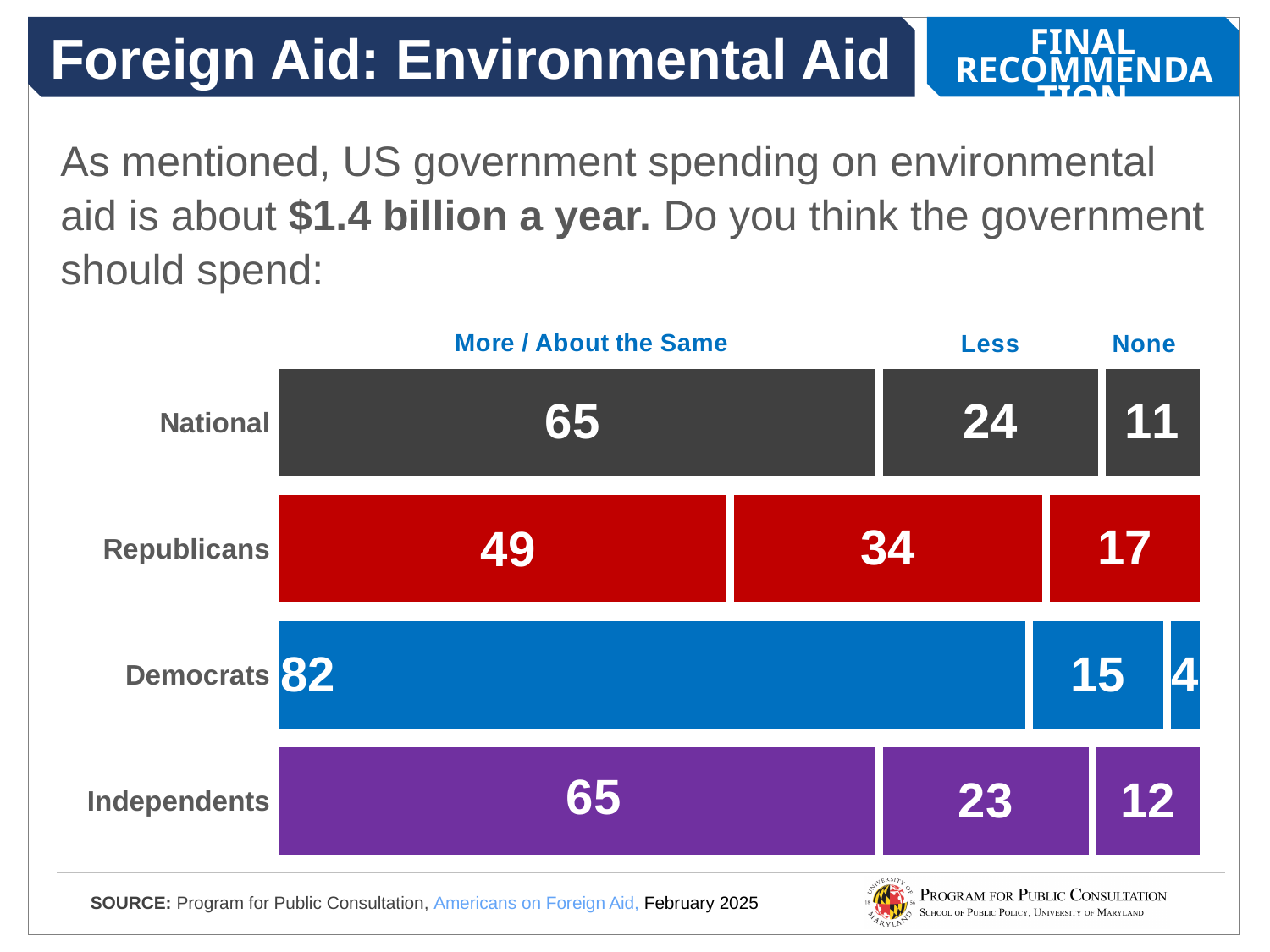
What percentage of Democrats say the government should spend more or about the same on environmental aid? 82 Which group has the highest value for 'More / About the Same'? Democrats How many response categories are shown across the top of the chart? 3 What is the difference between the Democrats and Republicans values for 'More / About the Same'? 33 Which group has the lowest value for 'None'? Democrats What is the Independents value for 'Less'? 23 What kind of chart is shown on the slide? Stacked bar chart Which is larger: the Republicans value for 'Less' or the Independents value for 'Less'? Republicans How many groups (bars) are shown in the chart? 4 What is the Republicans value for 'None'? 17 What is the National value for 'Less'? 24 What is the total of the Republicans bar (49 + 34 + 17)? 100